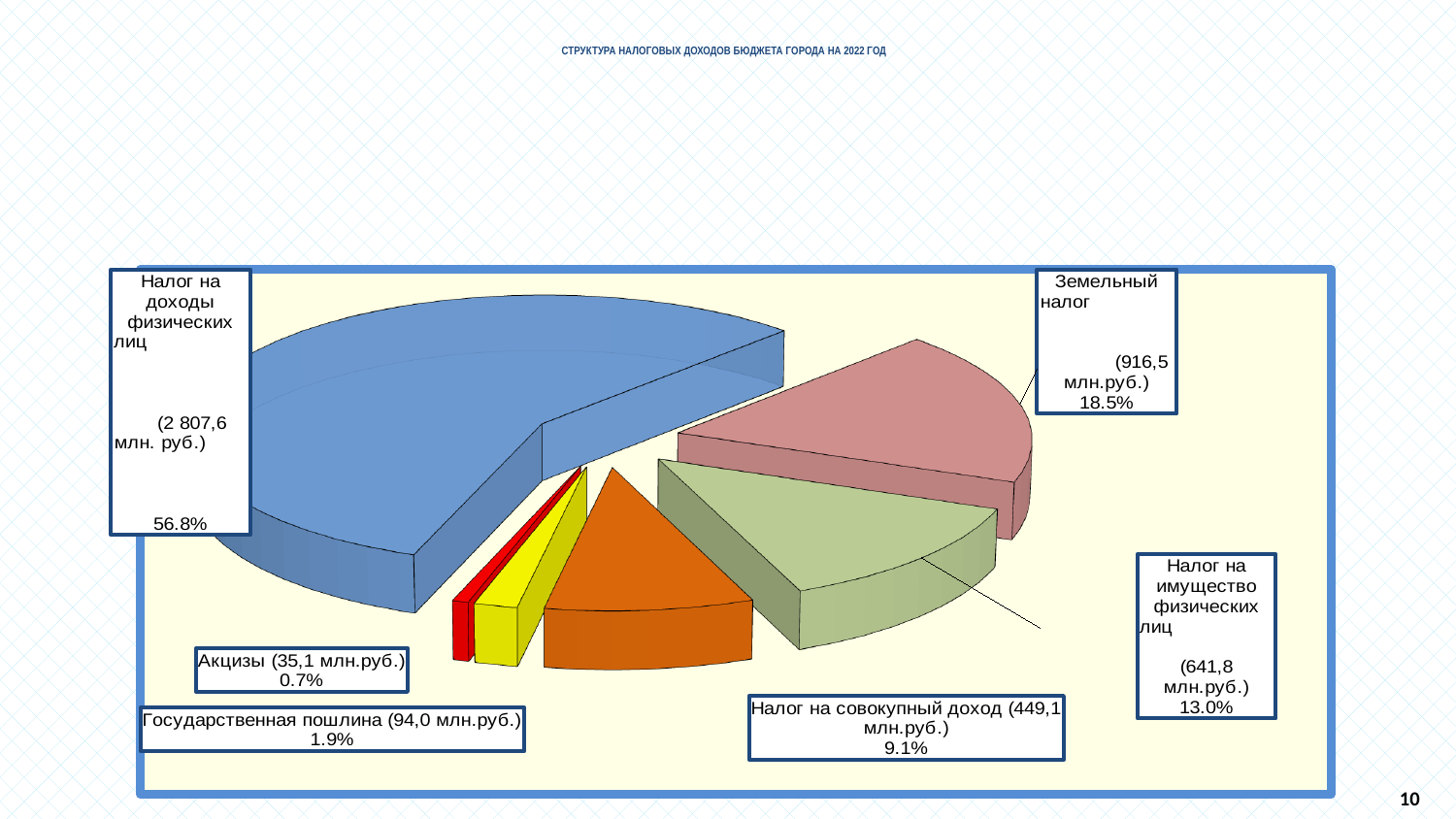
Which is larger: the share for Земельный налог or the share for Налог на имущество физических лиц? Земельный налог What share of the pie does Налог на доходы физических лиц have? 56.8% What is the difference in percentage points between the share for Земельный налог and the share for Налог на совокупный доход? 9.4 What share of the pie does Государственная пошлина have? 1.9% What is the title of the chart? СТРУКТУРА НАЛОГОВЫХ ДОХОДОВ БЮДЖЕТА ГОРОДА НА 2022 ГОД What is the value shown for Налог на имущество физических лиц? 641,8 млн.руб. What is the value shown for Налог на совокупный доход? 449,1 млн.руб. Which category has the smallest share of the pie? Акцизы How many slices does the pie chart have? 6 What share of the pie does Земельный налог have? 18.5% Which category has the largest share of the pie? Налог на доходы физических лиц What kind of chart is shown on the slide? pie chart